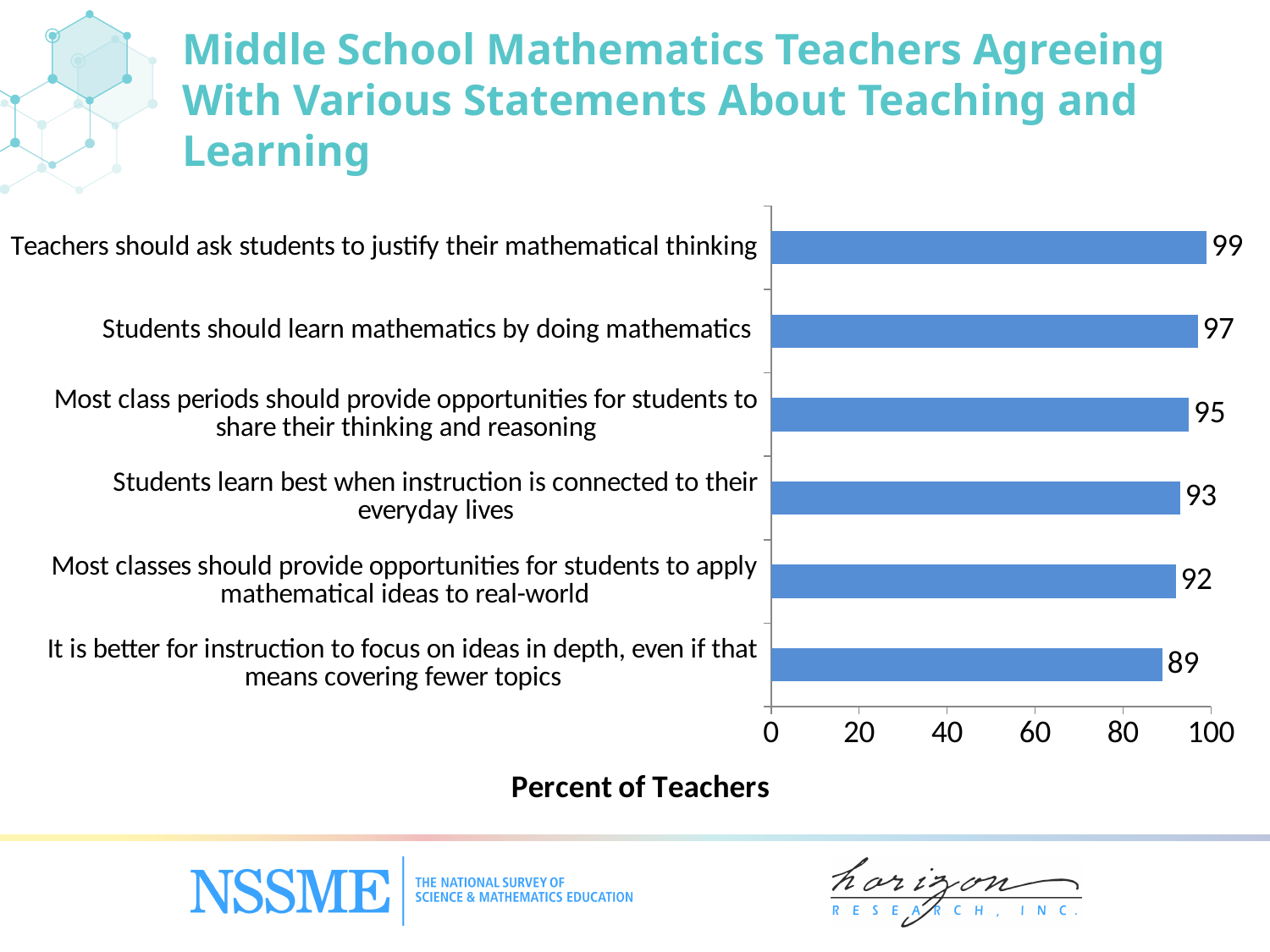
What is the difference in percent of teachers between 'Teachers should ask students to justify their mathematical thinking' and 'It is better for instruction to focus on ideas in depth, even if that means covering fewer topics'? 10 Which has a higher percent of teachers agreeing: 'Students should learn mathematics by doing mathematics' or 'Students learn best when instruction is connected to their everyday lives'? Students should learn mathematics by doing mathematics What is the label of the horizontal axis? Percent of Teachers What percent of teachers agree that it is better for instruction to focus on ideas in depth, even if that means covering fewer topics? 89 How many statements are shown in the chart? 6 Which statement has the lowest percent of teachers agreeing? It is better for instruction to focus on ideas in depth, even if that means covering fewer topics What percent of teachers agree that teachers should ask students to justify their mathematical thinking? 99 What kind of chart is shown on the slide? Bar chart Which statement has the highest percent of teachers agreeing? Teachers should ask students to justify their mathematical thinking What is the difference in percent of teachers between 'Most class periods should provide opportunities for students to share their thinking and reasoning' and 'Most classes should provide opportunities for students to apply mathematical ideas to real-world'? 3 What percent of teachers agree that students should learn mathematics by doing mathematics? 97 What percent of teachers agree that students learn best when instruction is connected to their everyday lives? 93